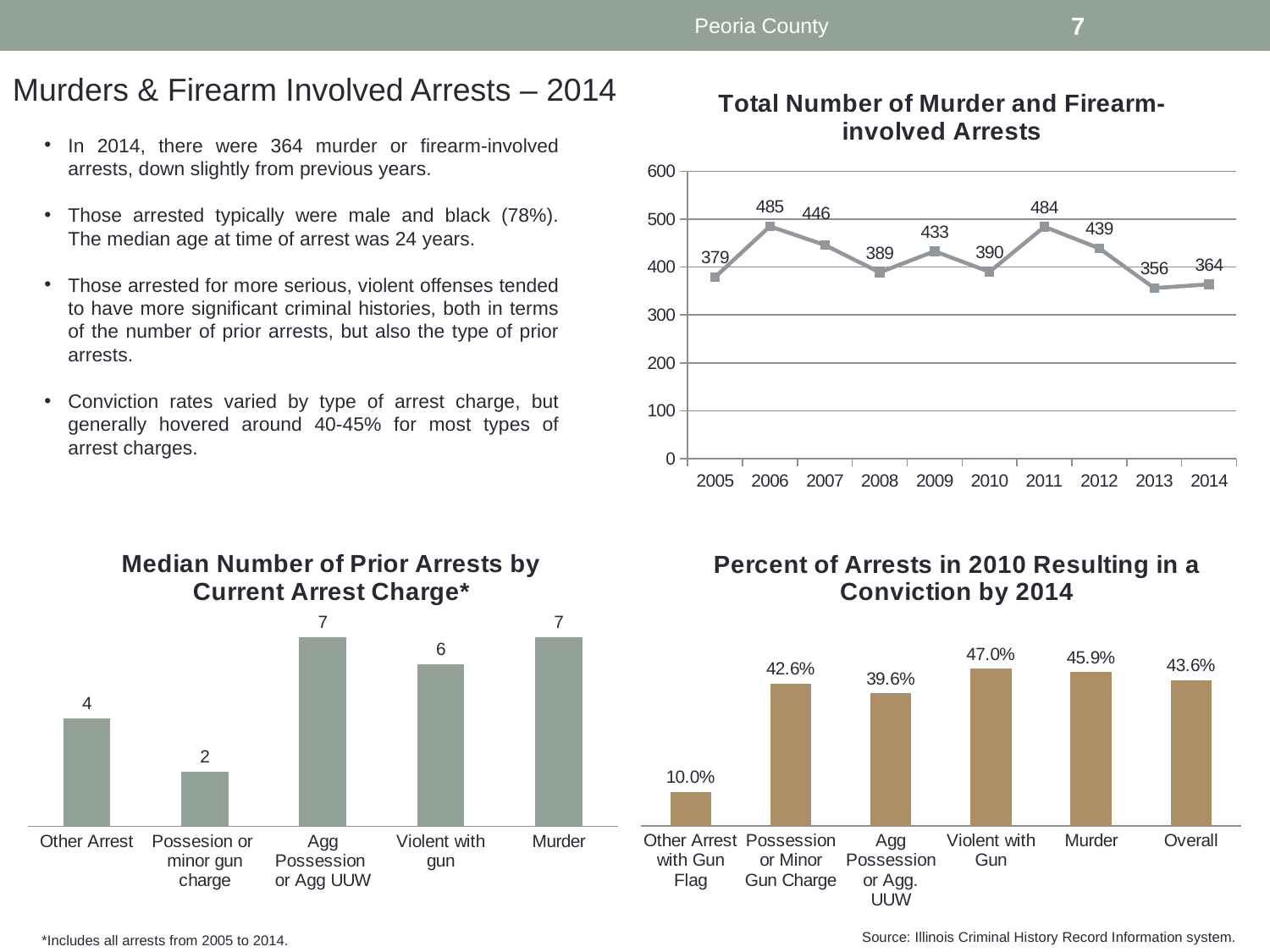
In the 'Total Number of Murder and Firearm-involved Arrests' chart, which year has the highest value? 2006 In the 'Total Number of Murder and Firearm-involved Arrests' chart, which year has the lowest value? 2013 In the 'Total Number of Murder and Firearm-involved Arrests' chart, what is the value for 2011? 484 What kind of chart is 'Total Number of Murder and Firearm-involved Arrests'? Line chart In the 'Median Number of Prior Arrests by Current Arrest Charge*' chart, which category has the lowest value? Possesion or minor gun charge In the 'Median Number of Prior Arrests by Current Arrest Charge*' chart, what is the value for Violent with gun? 6 In the 'Total Number of Murder and Firearm-involved Arrests' chart, how many years are plotted? 10 In the 'Median Number of Prior Arrests by Current Arrest Charge*' chart, is the value for Other Arrest larger or smaller than the value for Violent with gun? Smaller In the 'Percent of Arrests in 2010 Resulting in a Conviction by 2014' chart, what is the value for Murder? 45.9% In the 'Percent of Arrests in 2010 Resulting in a Conviction by 2014' chart, what is the difference between the Overall value and the Other Arrest with Gun Flag value? 33.6% In the 'Percent of Arrests in 2010 Resulting in a Conviction by 2014' chart, which category has the highest value? Violent with Gun In the 'Total Number of Murder and Firearm-involved Arrests' chart, what is the difference between the 2006 value and the 2014 value? 121